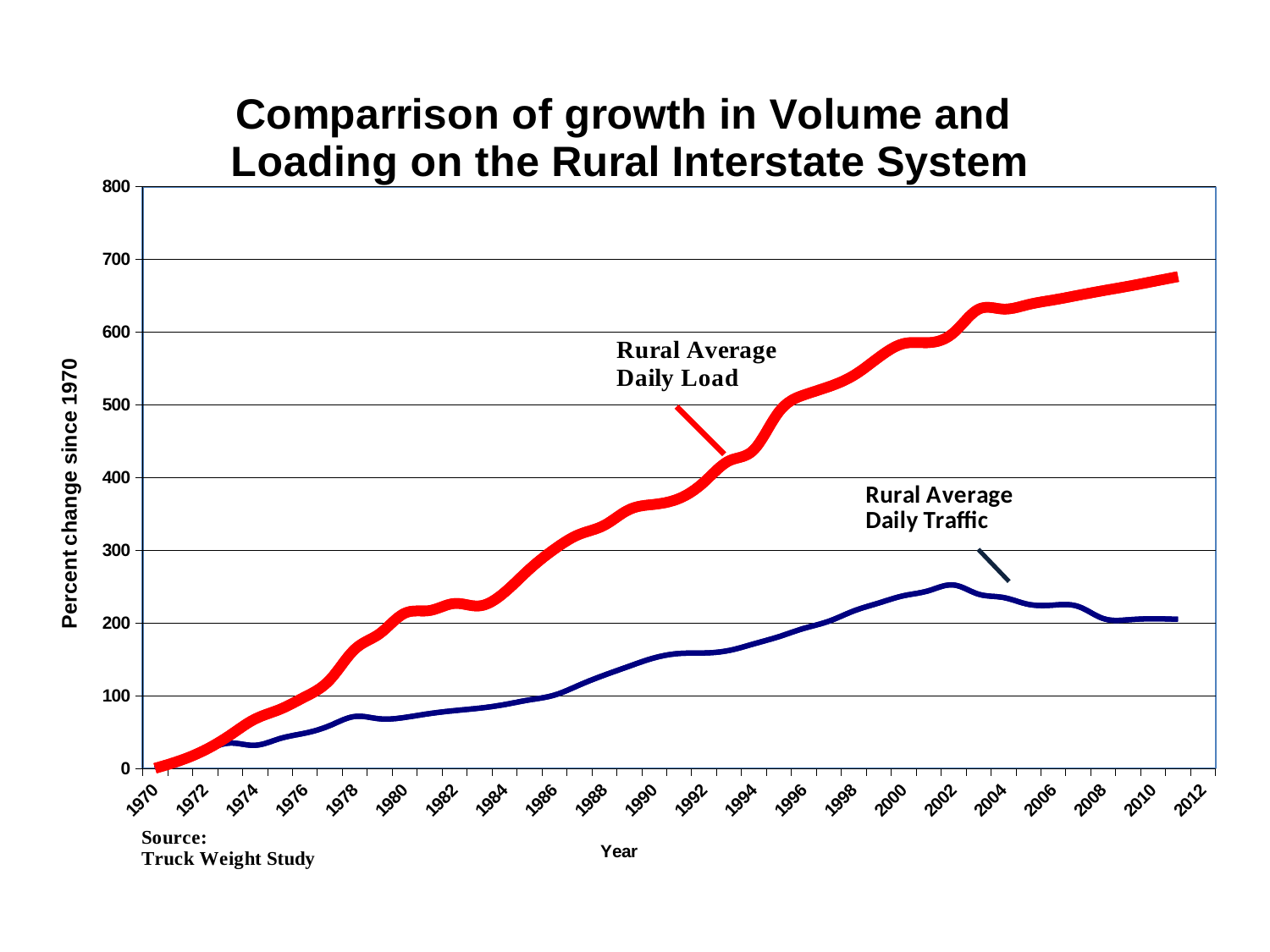
What is the label of the vertical axis? Percent change since 1970 Is the value for Rural Average Daily Load in 2010 greater or less than 600? greater Is the value for Rural Average Daily Traffic in 1990 greater or less than 100? greater In 2010, which series has the higher value, Rural Average Daily Load or Rural Average Daily Traffic? Rural Average Daily Load Is the value for Rural Average Daily Load in 2010 greater or less than 700? less What is the title of the chart? Comparrison of growth in Volume and Loading on the Rural Interstate System Does the Rural Average Daily Load series generally rise or fall from 1970 to 2010? rise How many data series are plotted on the chart? 2 What kind of chart is shown on the slide? line chart